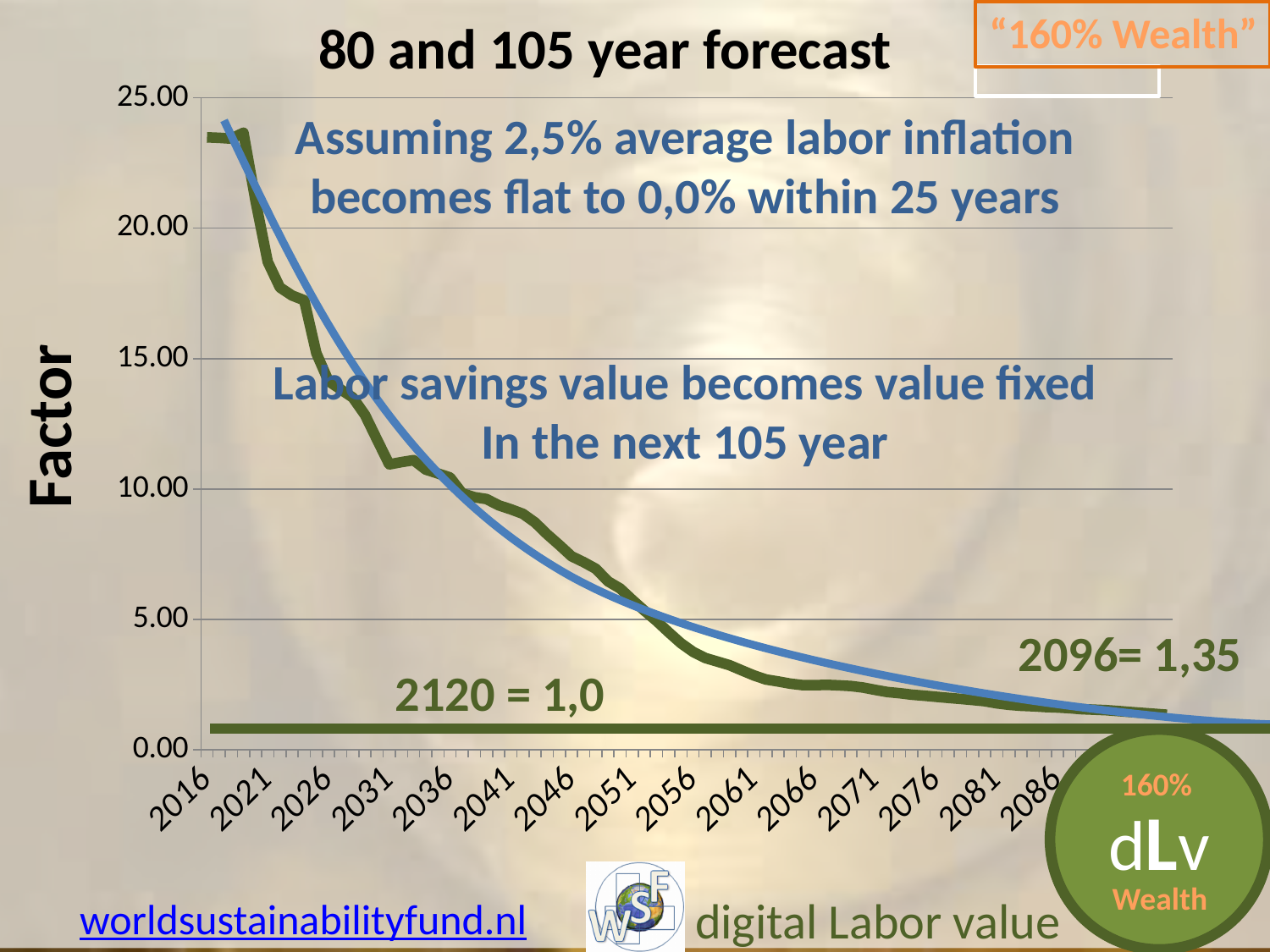
Is the value of the blue line at 2041 greater or less than 10.00? less Is the value of the green line at 2031 greater or less than 10.00? greater Is the value of the green line at 2086 greater or less than 5.00? less What kind of chart is shown on the slide? line chart Do the plotted lines rise or fall as the years increase along the x axis? fall What is the highest value shown on the vertical axis? 25.00 What value is annotated on the chart for the year 2096? 1,35 How many year labels are shown along the x axis? 15 What is the title of the chart? 80 and 105 year forecast What is the label on the vertical axis of the chart? Factor What value is annotated on the chart for the year 2120? 1,0